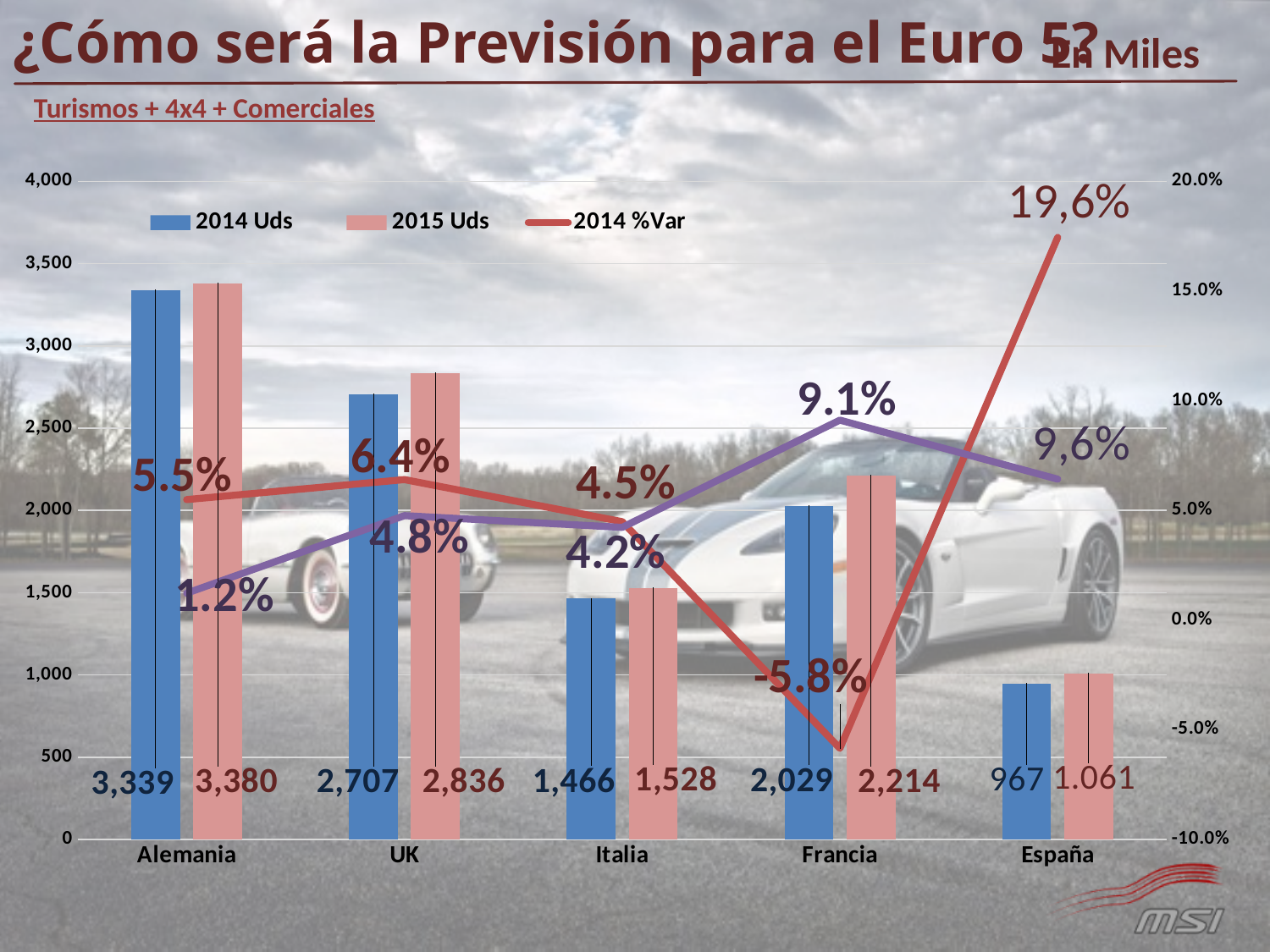
What is the difference between the 2015 Uds and 2014 Uds values for Alemania? 41 How many series does the legend list? 3 Which is larger, the 2015 Uds value for UK or for Italia? UK How many countries are shown on the x axis? 5 Which country has the highest 2014 Uds value? Alemania Is the 2014 Uds value for UK greater or less than 2,500? greater What is the 2015 Uds value for Francia? 2,214 What is the 2014 %Var value for Francia? -5.8% What is the 2014 Uds value for Alemania? 3,339 What is the difference between the 2015 Uds and 2014 Uds values for Francia? 185 Which country has the highest 2014 %Var value? España Which country has the lowest 2015 Uds value? España